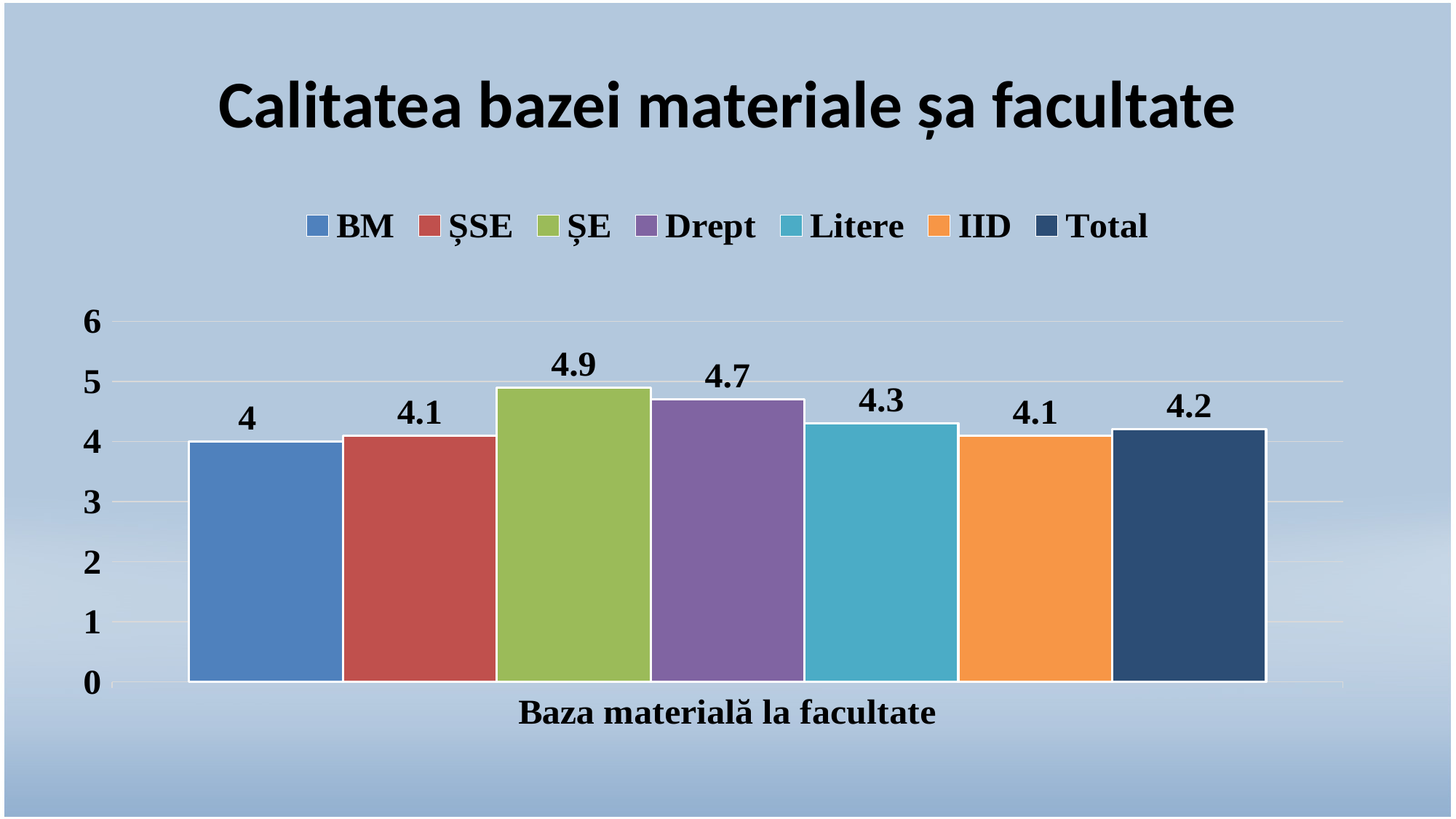
What is the value for ȘE? 4.9 What kind of chart is shown on the slide? Bar chart Which series has the lowest value? BM Which is larger, the value for Drept or the value for IID? Drept What is the title of the chart? Calitatea bazei materiale șa facultate How many series does the legend list? 7 What is the difference between the values for ȘE and Drept? 0.2 What is the difference between the values for Litere and BM? 0.3 What is the value for BM? 4 What is the value for Litere? 4.3 Which series has the highest value? ȘE What is the value for Total? 4.2